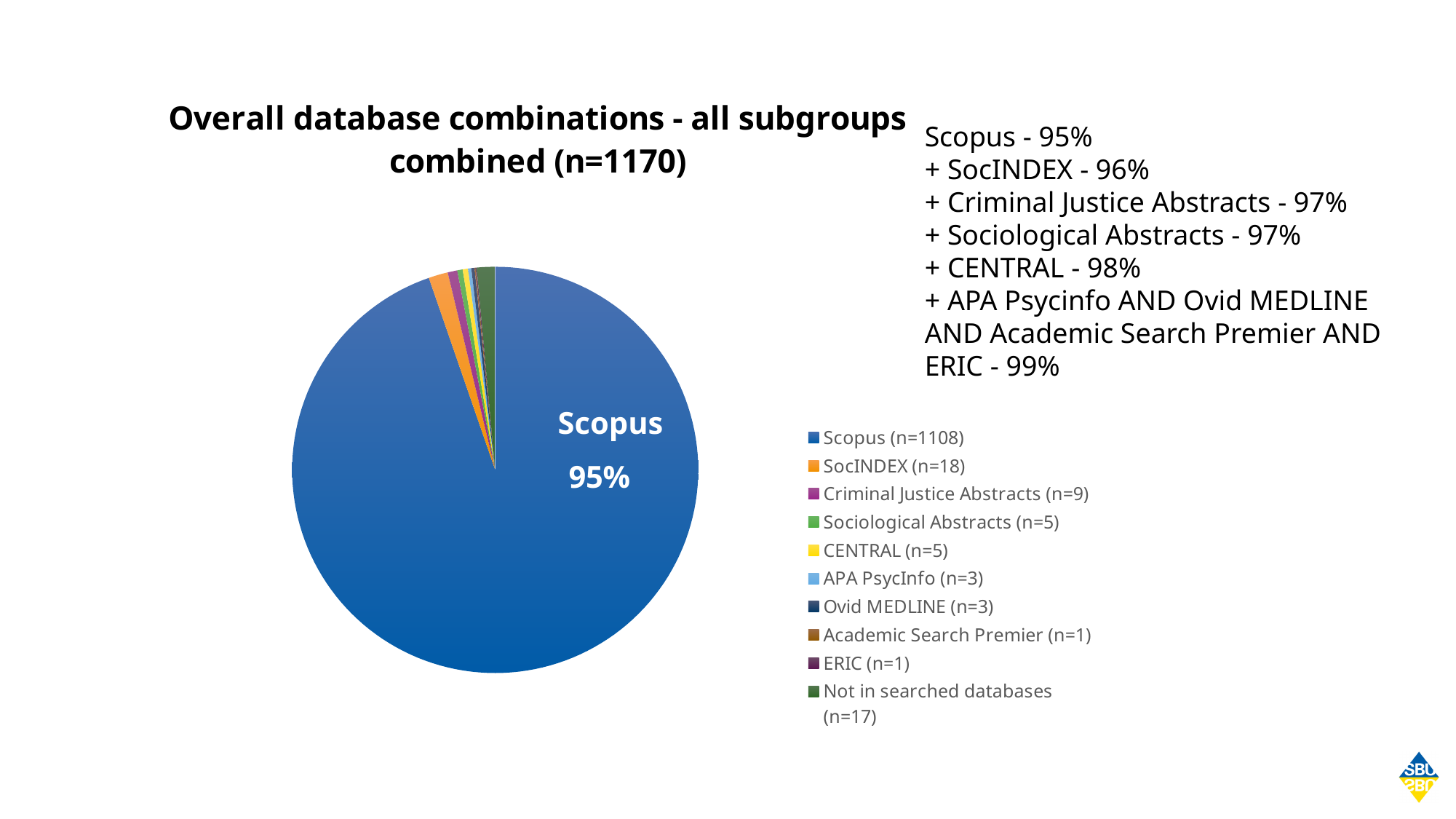
Which has a larger n value in the legend, SocINDEX or Criminal Justice Abstracts? SocINDEX What is the total n given in the chart title? 1170 What is the difference between the n values for Scopus and SocINDEX shown in the legend? 1090 According to the legend, what is the n value for SocINDEX? 18 According to the legend, what is the n value for Not in searched databases? 17 What share of the pie does the Scopus slice represent? 95% What kind of chart is shown on the slide? pie chart How many categories does the legend list? 10 Which category has the largest slice of the pie? Scopus According to the legend, what is the n value for Criminal Justice Abstracts? 9 What is the title of the chart? Overall database combinations - all subgroups combined (n=1170) What colour is the Scopus slice of the pie? blue